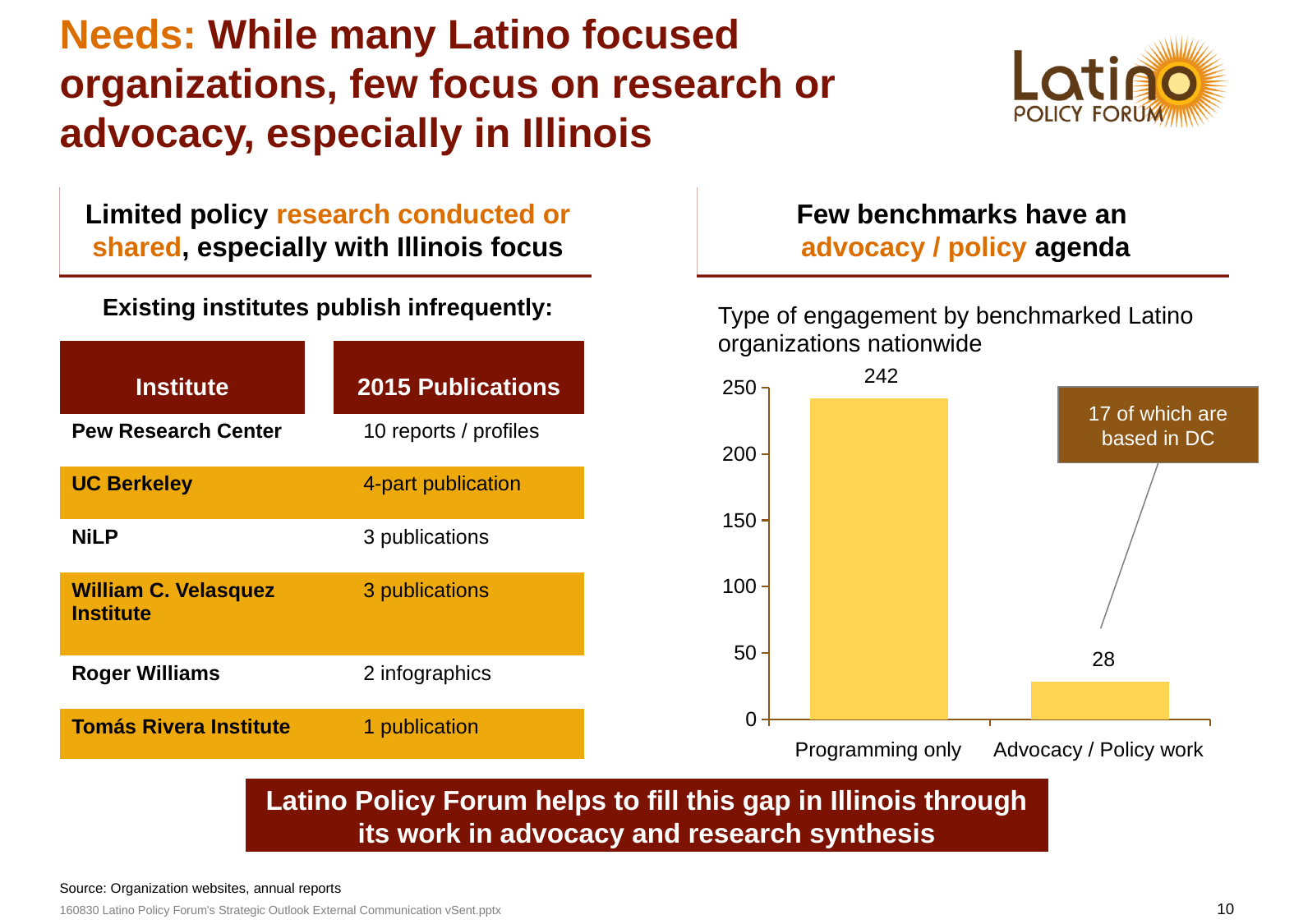
Which is larger, the value for Programming only or the value for Advocacy / Policy work? Programming only What is the value for Advocacy / Policy work? 28 According to the callout on the chart, how many of the Advocacy / Policy work organizations are based in DC? 17 Is the value for Advocacy / Policy work greater or less than 50? less How many categories are shown on the x axis of the chart? 2 Which category has the lowest value? Advocacy / Policy work What is the difference between the values for Programming only and Advocacy / Policy work? 214 What is the title of the chart? Type of engagement by benchmarked Latino organizations nationwide What kind of chart is shown on the slide? bar chart What is the value for Programming only? 242 Is the value for Programming only greater or less than 200? greater Which category has the highest value? Programming only